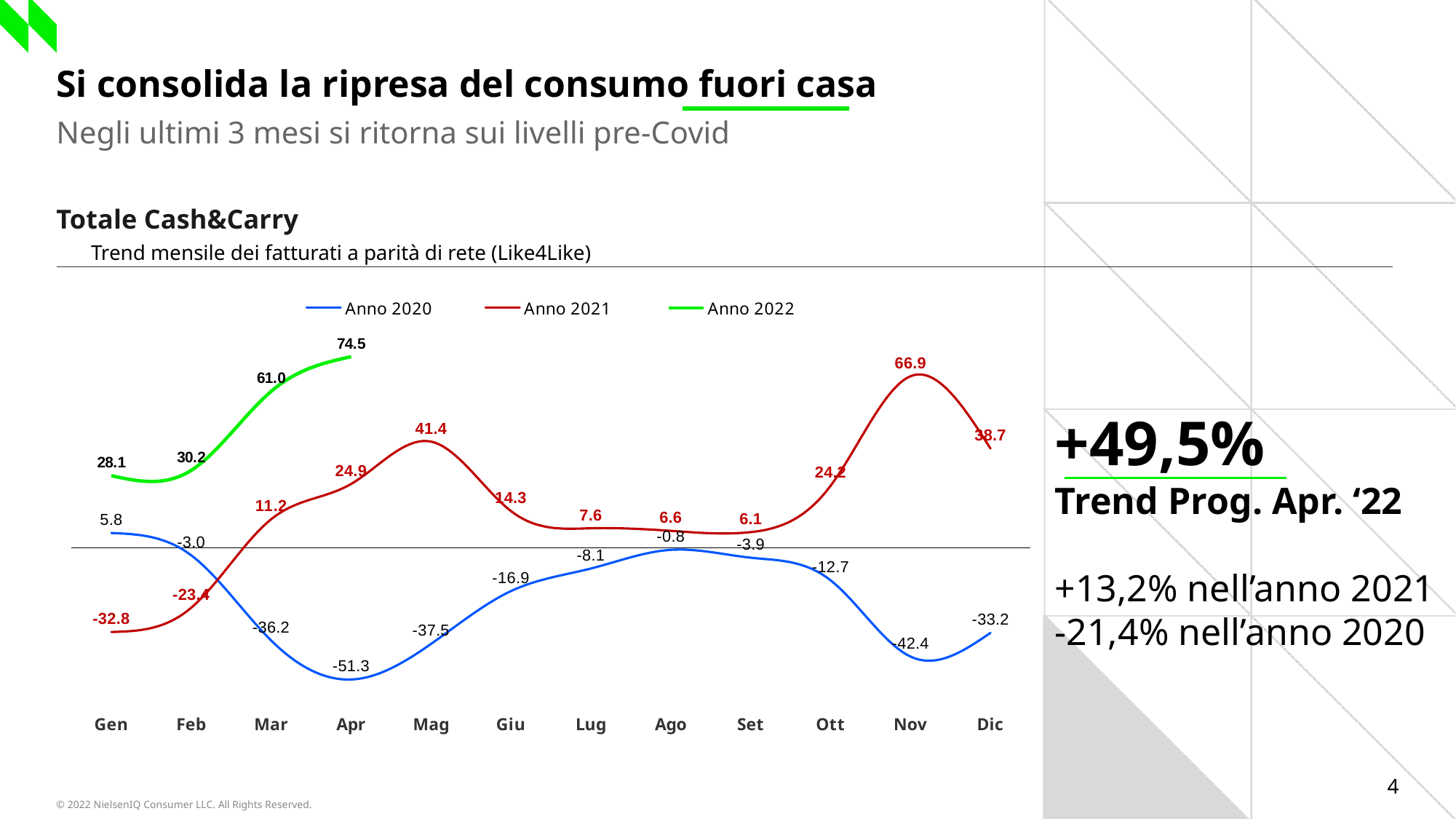
Which is larger in Mag: the Anno 2021 value or the Anno 2020 value? Anno 2021 Which colour is used for the Anno 2020 line? Blue What is the value for Anno 2021 in Nov? 66.9 What type of chart is shown on the slide? Line chart In which month does Anno 2021 reach its highest value? Nov How many months have a data point for Anno 2022? 4 Do the Anno 2022 values rise or fall from Gen to Apr? Rise What is the value for Anno 2020 in Apr? -51.3 How many series does the legend list? 3 What is the value for Anno 2022 in Mar? 61.0 In which month does Anno 2020 reach its lowest value? Apr What is the difference between the Anno 2022 and Anno 2021 values in Apr? 49.6